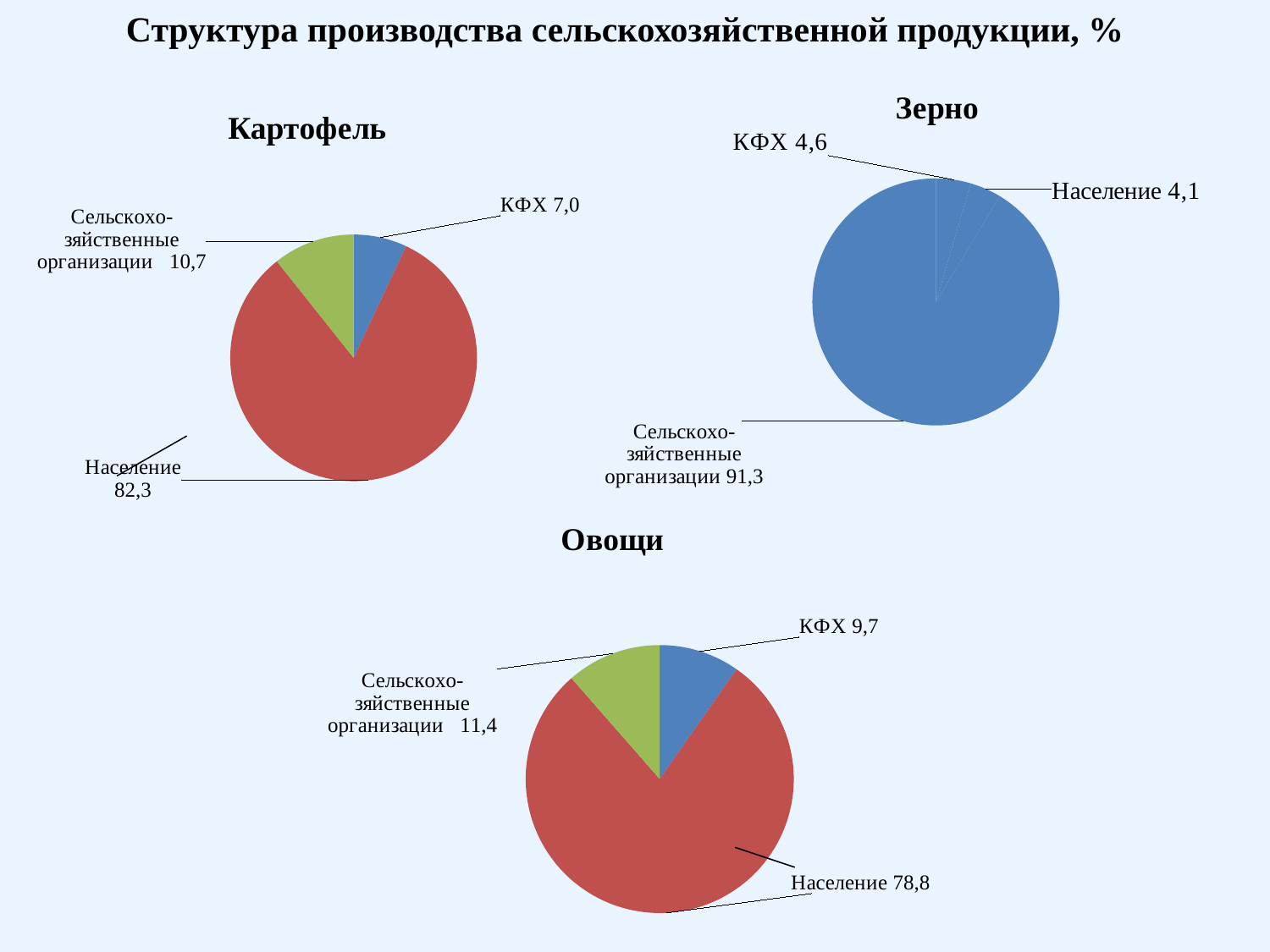
What kind of chart is the Овощи chart? Pie chart In the Овощи chart, what is the value for Сельскохозяйственные организации? 11,4 In the Картофель chart, what is the difference between Население and Сельскохозяйственные организации? 71,6 What is the title of the slide? Структура производства сельскохозяйственной продукции, % How many charts are on the slide? 3 In the Овощи chart, which category has the largest share? Население In the Зерно chart, which category has the smallest share? Население In the Зерно chart, what is the value for Сельскохозяйственные организации? 91,3 In the Картофель chart, what is the value for Население? 82,3 In the Овощи chart, which is larger: КФХ or Сельскохозяйственные организации? Сельскохозяйственные организации How many categories does the Зерно chart show? 3 In the Картофель chart, what is the value for КФХ? 7,0